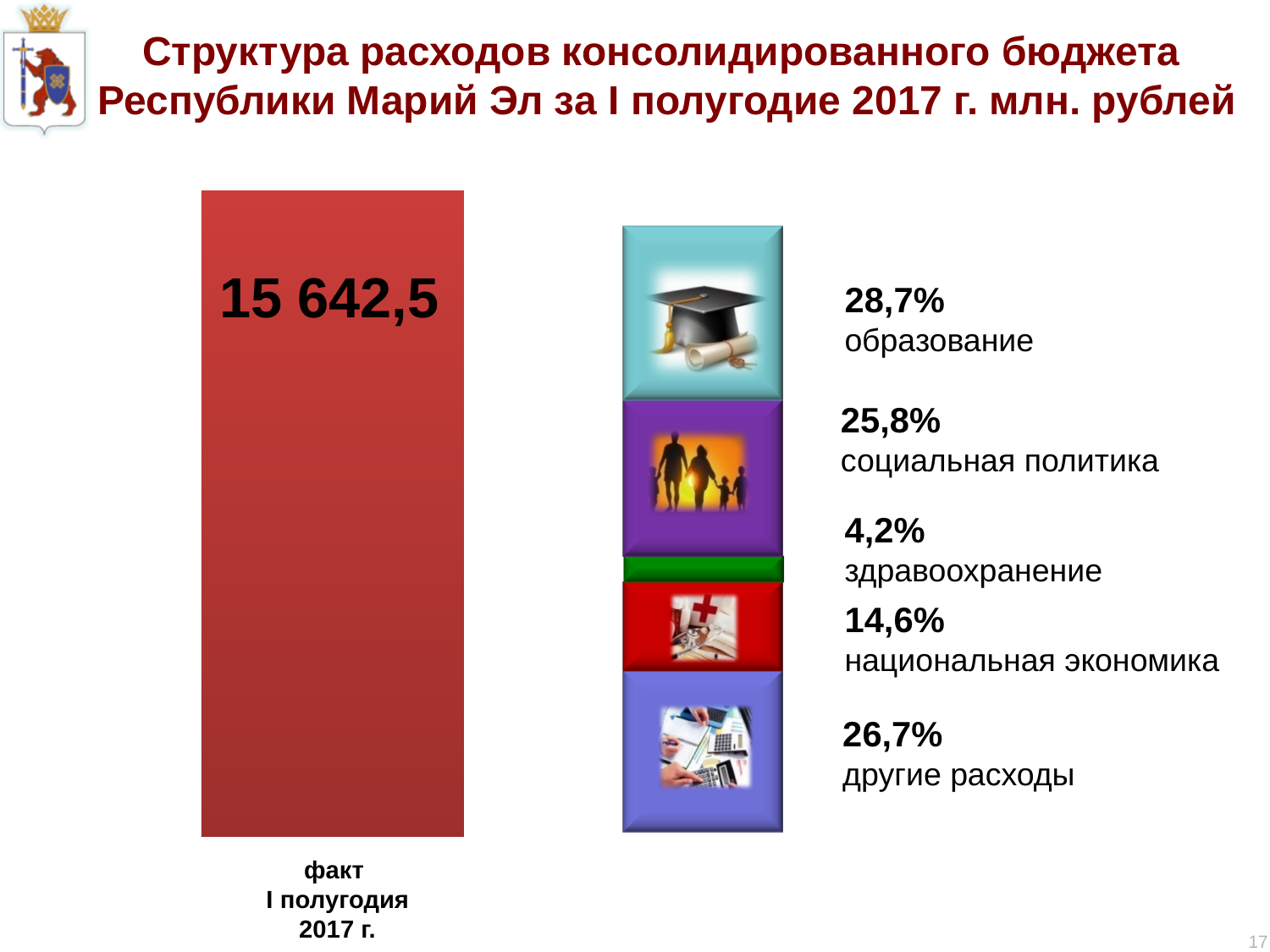
What share of expenditure goes to социальная политика? 25,8% What is the total consolidated budget expenditure shown on the large red bar? 15 642,5 Which is larger, the share for другие расходы or for национальная экономика? другие расходы Which expenditure category has the largest share? образование How many expenditure categories are shown in the stacked bar? 5 What kind of chart is used to show the expenditure structure? bar chart What is the difference in percentage points between образование and социальная политика? 2,9 What share of expenditure goes to национальная экономика? 14,6% What share of expenditure goes to образование (education)? 28,7% Which expenditure category has the smallest share? здравоохранение What share of expenditure goes to здравоохранение? 4,2% What share of expenditure is labelled другие расходы? 26,7%